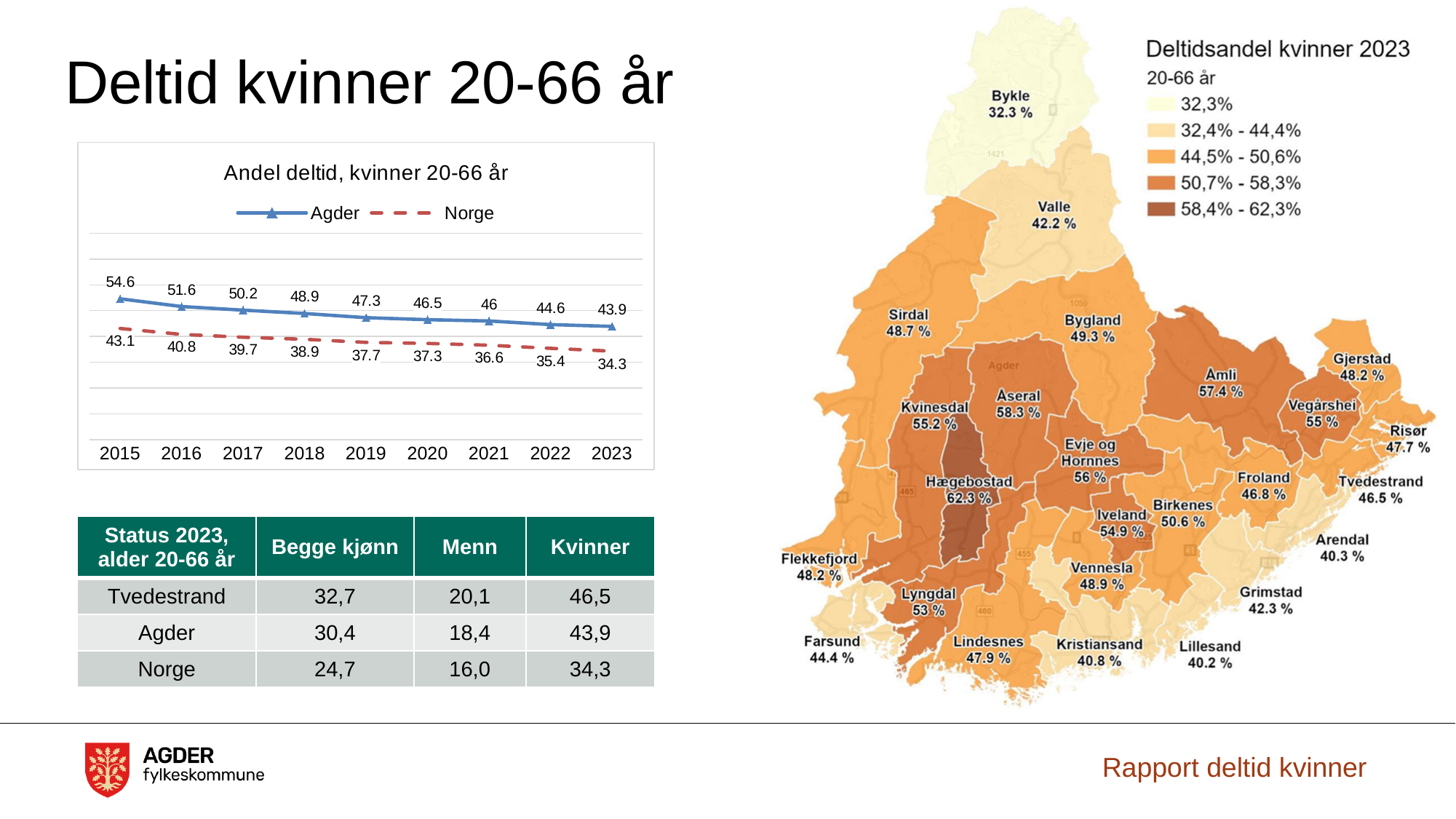
In the chart 'Andel deltid, kvinner 20-66 år', what is the difference between Agder and Norge in 2023? 9.6 What kind of chart is 'Andel deltid, kvinner 20-66 år'? Line chart How many years are shown on the x axis of the chart 'Andel deltid, kvinner 20-66 år'? 9 In the chart 'Andel deltid, kvinner 20-66 år', which series has the higher value in 2019, Agder or Norge? Agder In the chart 'Andel deltid, kvinner 20-66 år', do the Agder values rise or fall from 2015 to 2023? Fall In the chart 'Andel deltid, kvinner 20-66 år', what is the difference between the Agder value in 2015 and in 2023? 10.7 In the line chart 'Andel deltid, kvinner 20-66 år', what is the value for Agder in 2015? 54.6 In the map 'Deltidsandel kvinner 2023', what is the value shown for Hægebostad? 62.3 % In the line chart 'Andel deltid, kvinner 20-66 år', what is the value for Norge in 2023? 34.3 In the chart 'Andel deltid, kvinner 20-66 år', in which year is the Agder value highest? 2015 How many series does the legend of the chart 'Andel deltid, kvinner 20-66 år' list? 2 In the chart 'Andel deltid, kvinner 20-66 år', in which year is the Norge value lowest? 2023